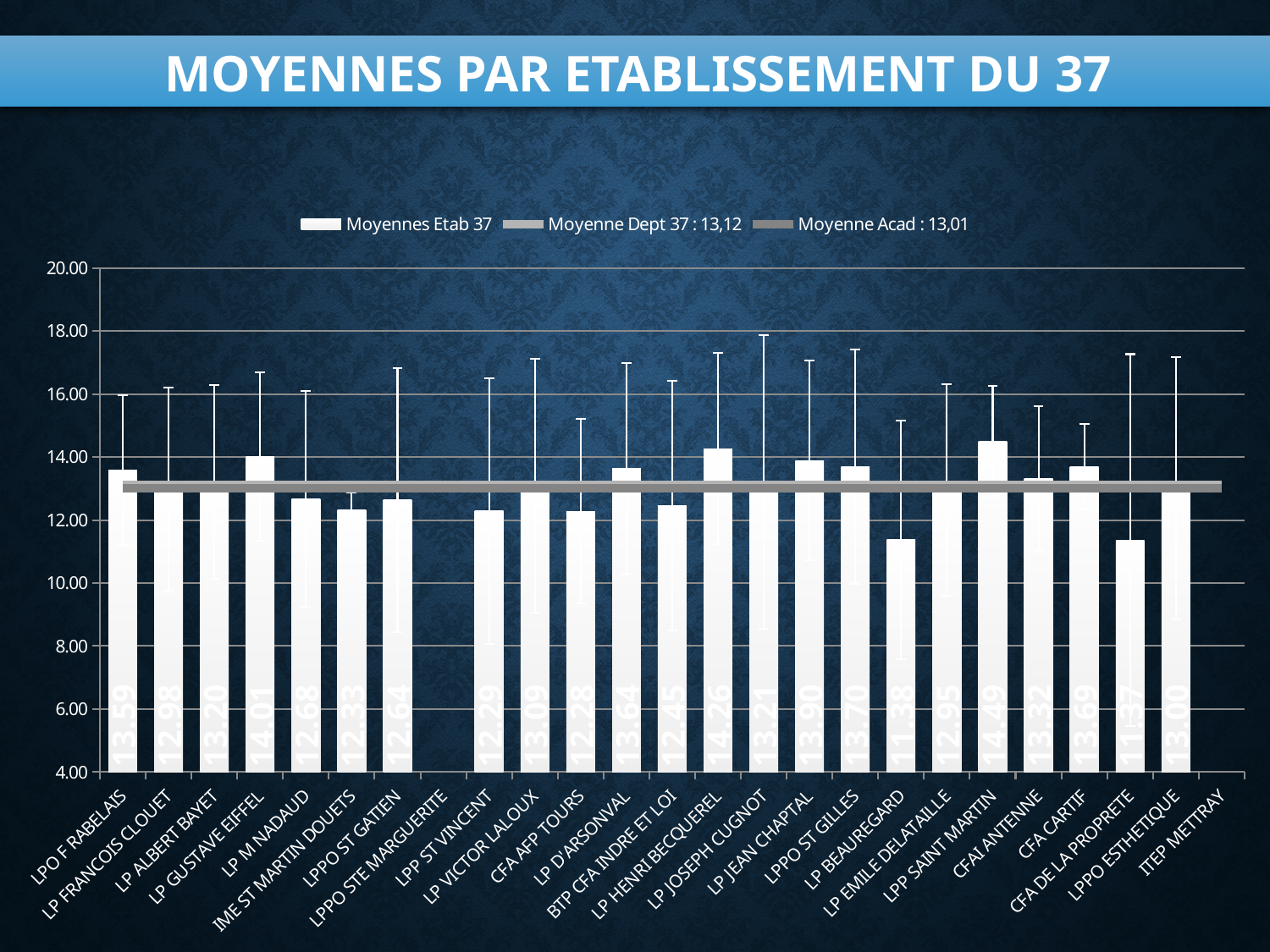
What is the value for LP GUSTAVE EIFFEL? 14.01 What is the difference between the values for LPP SAINT MARTIN and LP BEAUREGARD? 3.11 How many bars are plotted in the chart? 23 What is the title of the chart? MOYENNES PAR ETABLISSEMENT DU 37 What is the value for LP HENRI BECQUEREL? 14.26 What value does the legend give for Moyenne Dept 37? 13,12 What is the value for CFA CARTIF? 13.69 Which establishment has the highest value? LPP SAINT MARTIN How many series does the legend list? 3 Is the value for LP BEAUREGARD greater or less than 12.00? less Which is larger, the value for LP JEAN CHAPTAL or the value for LPPO ST GILLES? LP JEAN CHAPTAL What kind of chart is shown on the slide? bar chart